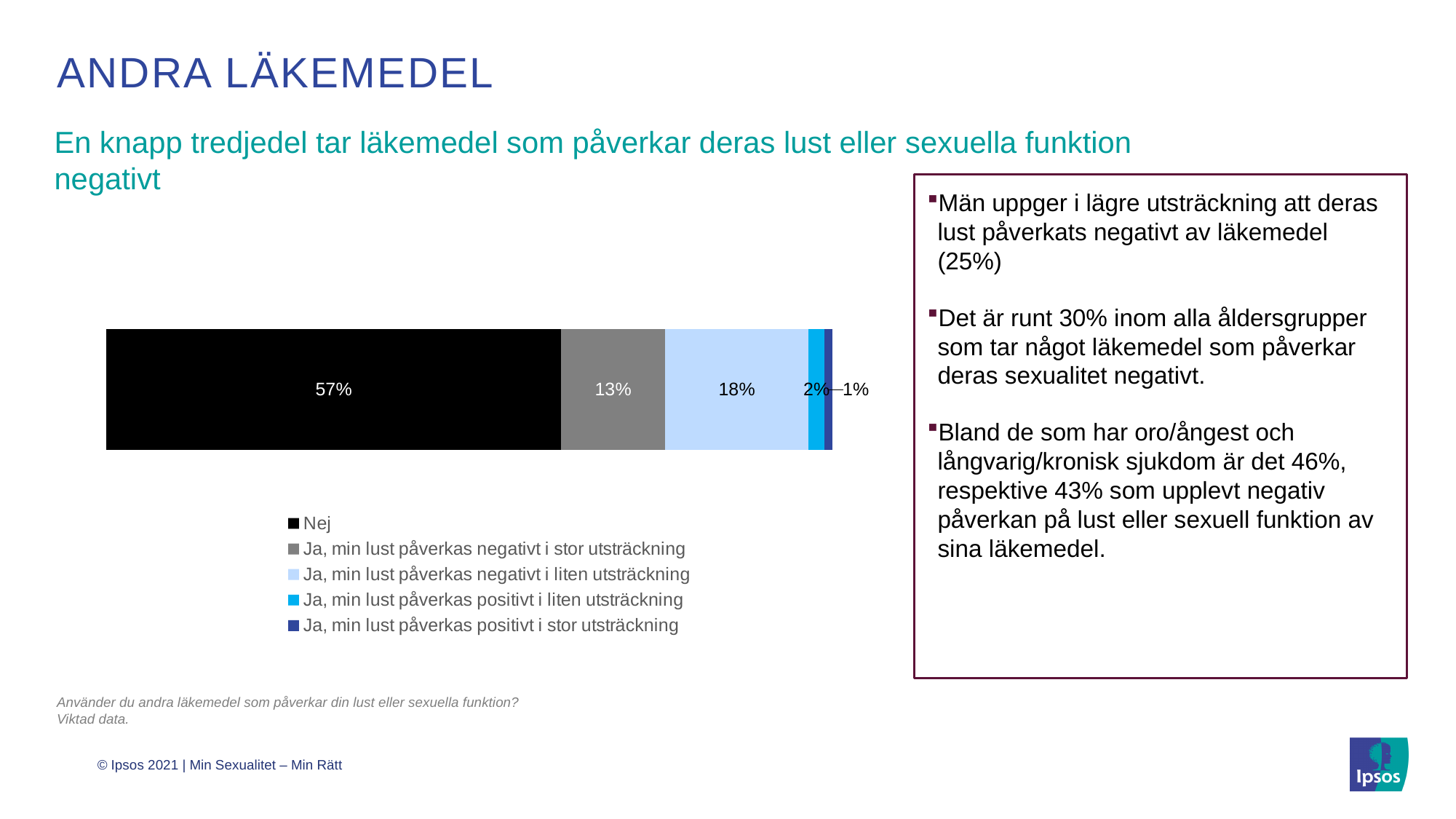
How many series does the legend list? 5 What is the difference between the "Nej" share and the "Ja, min lust påverkas negativt i liten utsträckning" share? 39 percentage points Which response category has the largest share in the bar? Nej What is the value for "Ja, min lust påverkas positivt i stor utsträckning"? 1% What is the value for "Ja, min lust påverkas negativt i liten utsträckning"? 18% What colour is the segment for "Nej"? Black Which response category has the smallest share in the bar? Ja, min lust påverkas positivt i stor utsträckning What is the value for "Ja, min lust påverkas positivt i liten utsträckning"? 2% What is the value for "Ja, min lust påverkas negativt i stor utsträckning"? 13% What share of respondents answered "Nej"? 57% Which is larger: "Ja, min lust påverkas negativt i stor utsträckning" or "Ja, min lust påverkas negativt i liten utsträckning"? Ja, min lust påverkas negativt i liten utsträckning What kind of chart is shown on the slide? Stacked bar chart